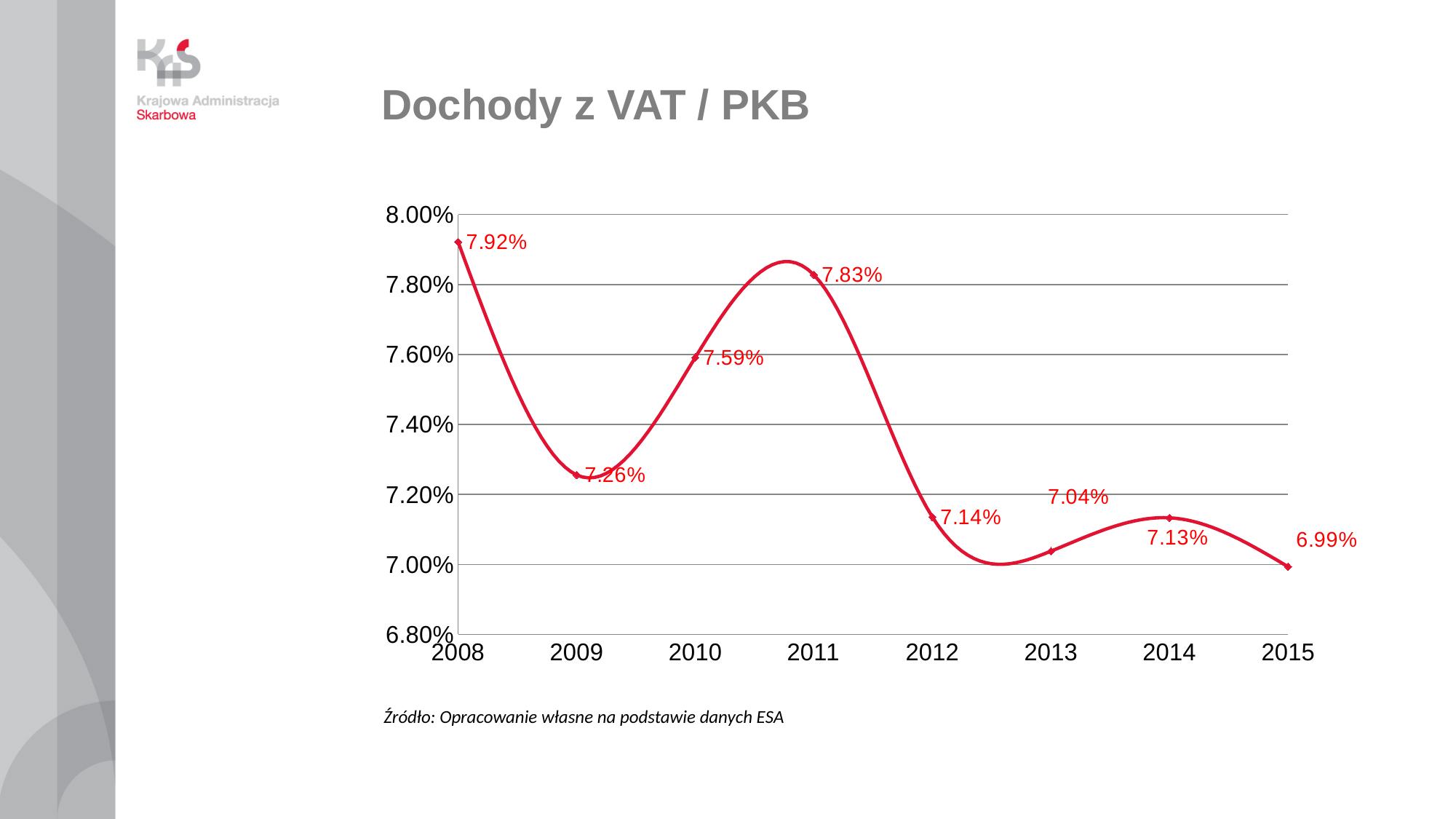
Is the value for 2009 greater or less than 7.40%? less What is the value for 2011? 7.83% How many years are plotted on the chart? 8 What is the value for 2012? 7.14% What is the difference between the values for 2008 and 2015? 0.93% Which year has the highest value? 2008 Which is larger, the value for 2010 or the value for 2011? 2011 What is the value for 2008? 7.92% Which year has the lowest value? 2015 What kind of chart is shown on the slide? line chart What is the title of the chart? Dochody z VAT / PKB What is the value for 2015? 6.99%